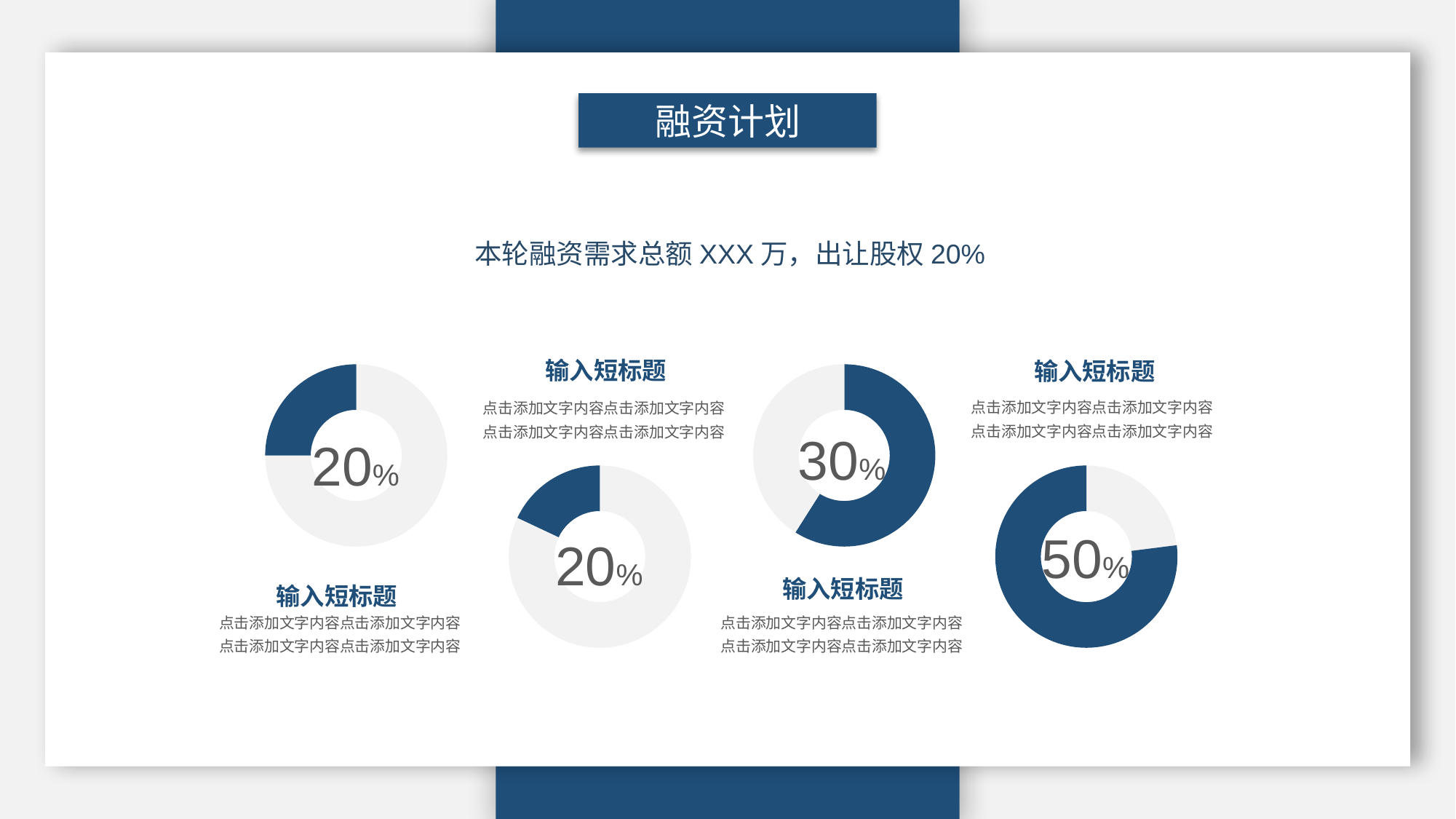
What colour is the filled (highlighted) portion of each donut chart? dark blue Which donut chart shows the highest percentage? the rightmost chart (50%) What percentage is shown in the third donut chart from the left? 30% What is the difference between the percentage in the rightmost donut chart and the percentage in the leftmost donut chart? 30% What is the title shown at the top of the slide? 融资计划 What percentage is shown in the rightmost donut chart? 50% Is the percentage in the rightmost donut chart larger than the percentage in the third donut chart from the left? yes What kind of chart is the leftmost chart on the slide? donut chart What percentage is shown in the second donut chart from the left? 20% What is the difference between the percentage in the third donut chart from the left and the percentage in the second donut chart from the left? 10% What percentage is shown in the leftmost donut chart? 20% How many donut charts are shown on the slide? 4